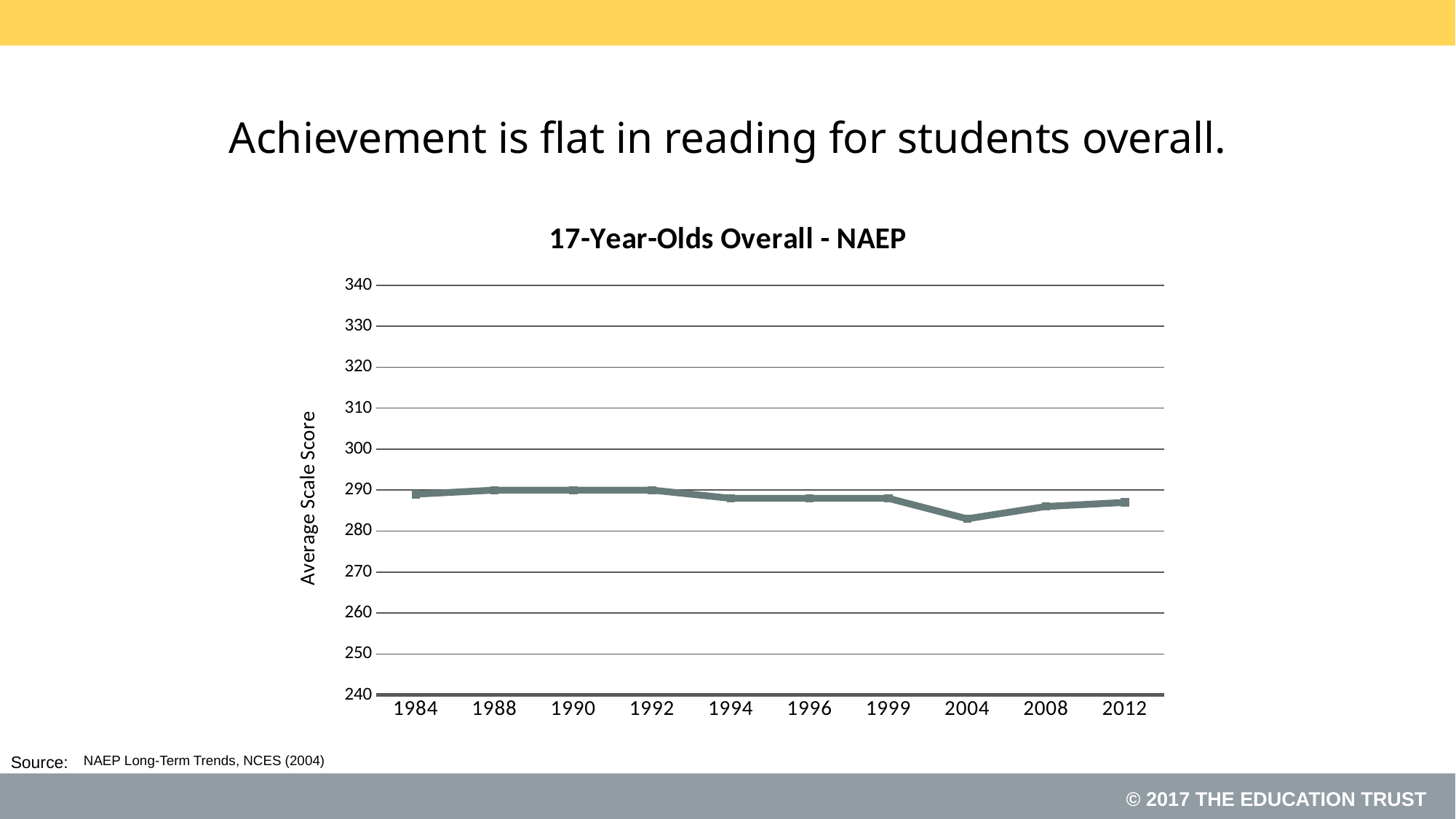
Is the value for 2004 greater or less than 290? less Is the value for 2012 greater or less than 300? less Do the values rise or fall from 2004 to 2012? rise Which is larger, the value for 2004 or the value for 2012? 2012 Which is larger, the value for 1992 or the value for 2004? 1992 How many years are plotted along the x axis of the chart? 10 Do the values rise or fall from 1999 to 2004? fall What kind of chart is shown on the slide? line chart Which year has the lowest average scale score on the chart? 2004 What is the label on the vertical axis of the chart? Average Scale Score What is the title of the chart? 17-Year-Olds Overall - NAEP Is the value for 1988 greater or less than 280? greater